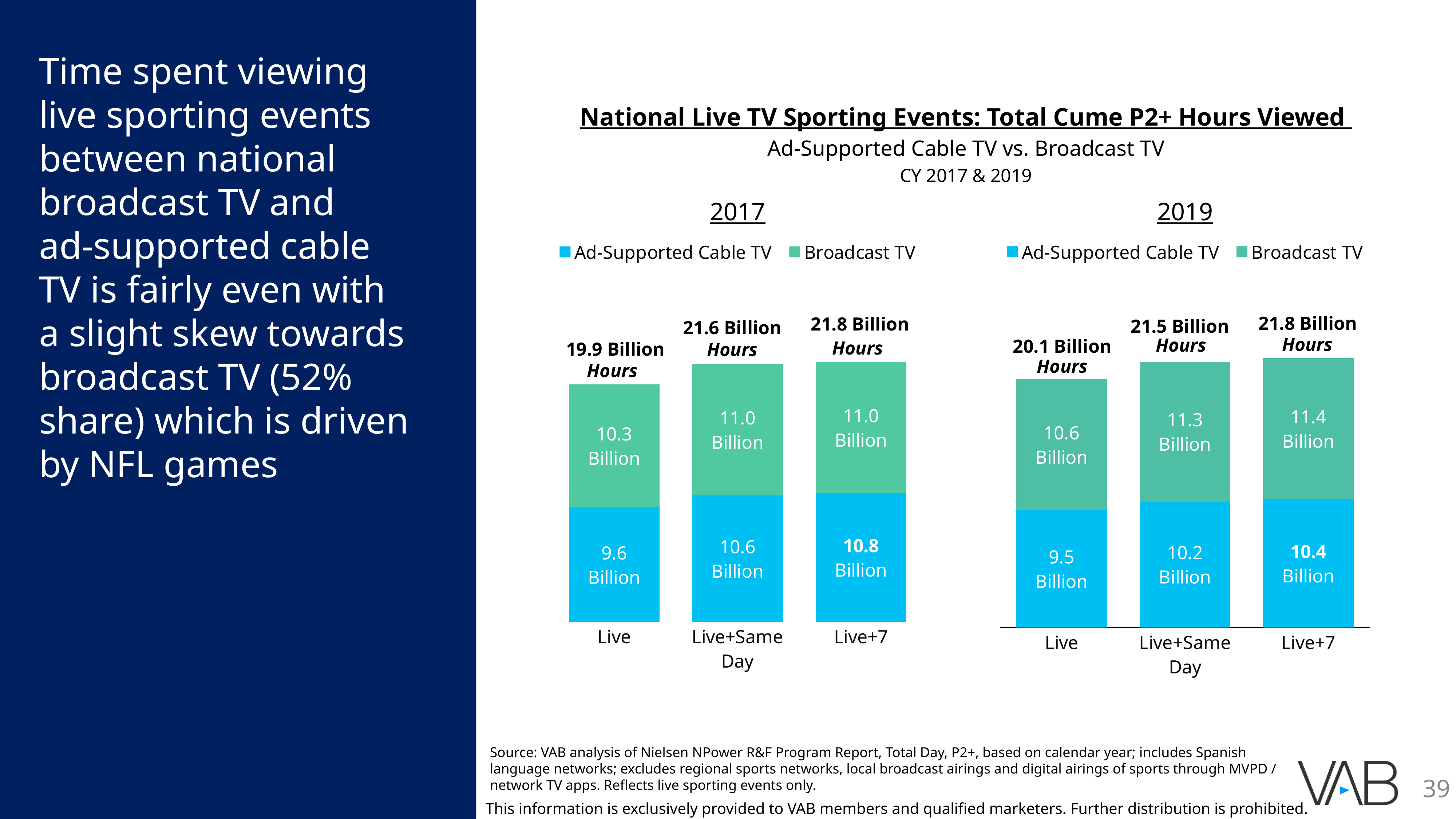
What kind of chart is the 2017 chart? Stacked bar chart How many categories are shown on the x axis of the 2019 chart? 3 In the 2019 chart, what is the total hours viewed for Live? 20.1 Billion Hours In the 2017 chart, what is the Ad-Supported Cable TV value for Live? 9.6 Billion How many series does the legend of the 2017 chart list? 2 In the 2019 chart, what is the difference between the Broadcast TV and Ad-Supported Cable TV values for Live+Same Day? 1.1 Billion In the 2017 chart, which is larger for Live+7: Ad-Supported Cable TV or Broadcast TV? Broadcast TV In the 2017 chart, which category has the lowest total hours viewed? Live In the 2019 chart, do the total hours viewed rise or fall from Live to Live+7? Rise In the 2019 chart, which category has the highest total hours viewed? Live+7 In the 2017 chart, what is the total hours viewed for Live+Same Day? 21.6 Billion Hours In the 2019 chart, what is the Broadcast TV value for Live+7? 11.4 Billion